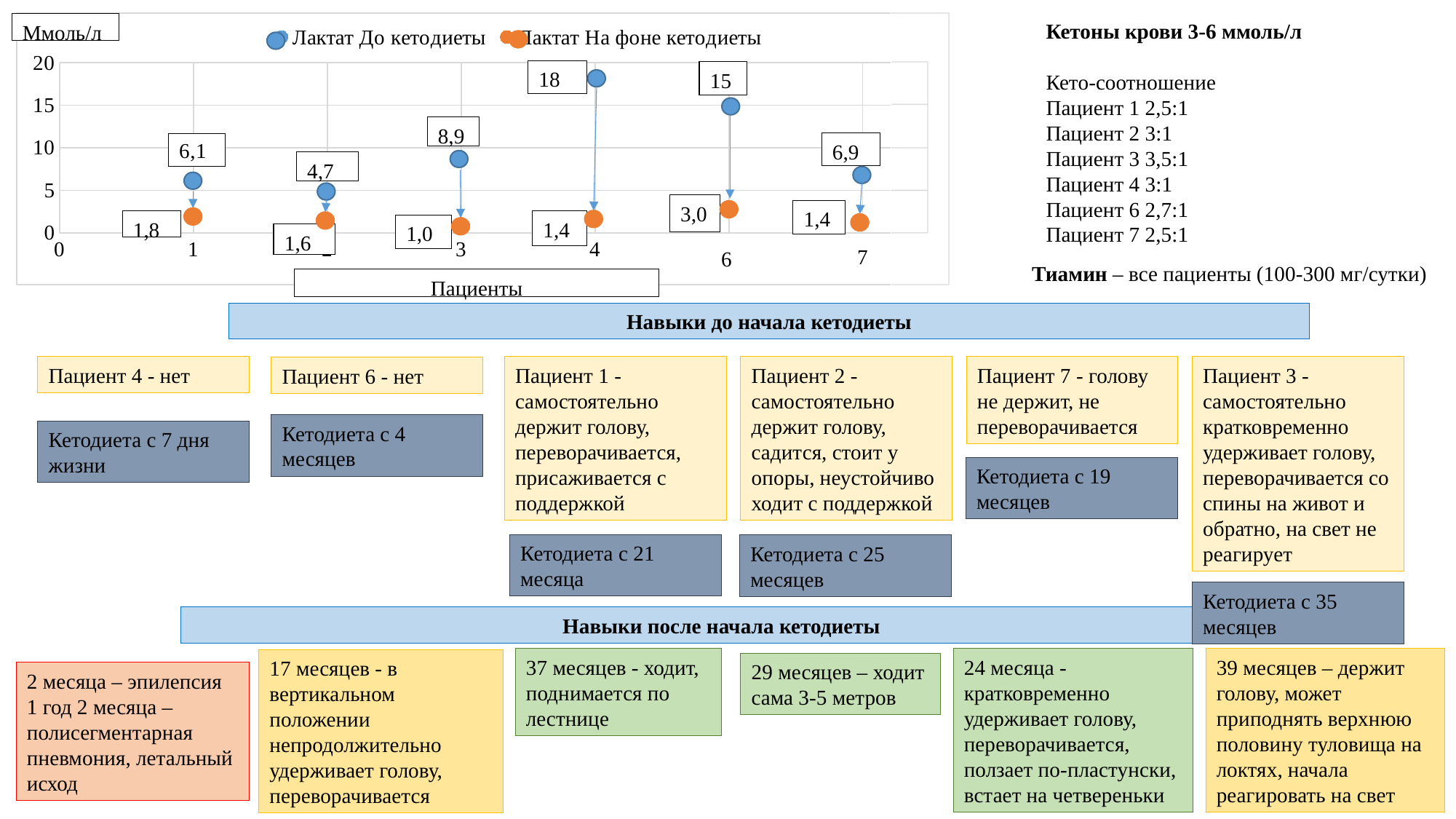
What kind of chart is shown on the slide? Scatter chart Which patient has the highest lactate value before the ketogenic diet? Patient 4 Is the lactate value before the ketogenic diet for patient 6 greater or less than 10? greater How many patients are plotted on the chart? 6 Which is larger: the lactate value before the ketogenic diet for patient 3 or for patient 7? Patient 3 What is the lactate value before the ketogenic diet for patient 3? 8,9 Which patient has the lowest lactate value during the ketogenic diet? Patient 3 What unit is shown on the vertical axis of the chart? Ммоль/л For patient 4, what is the difference between the lactate value before the ketogenic diet and during the ketogenic diet? 16,6 How many series does the chart legend list? 2 What is the lactate value during the ketogenic diet (Лактат На фоне кетодиеты) for patient 6? 3,0 What is the lactate value before the ketogenic diet (Лактат До кетодиеты) for patient 1? 6,1